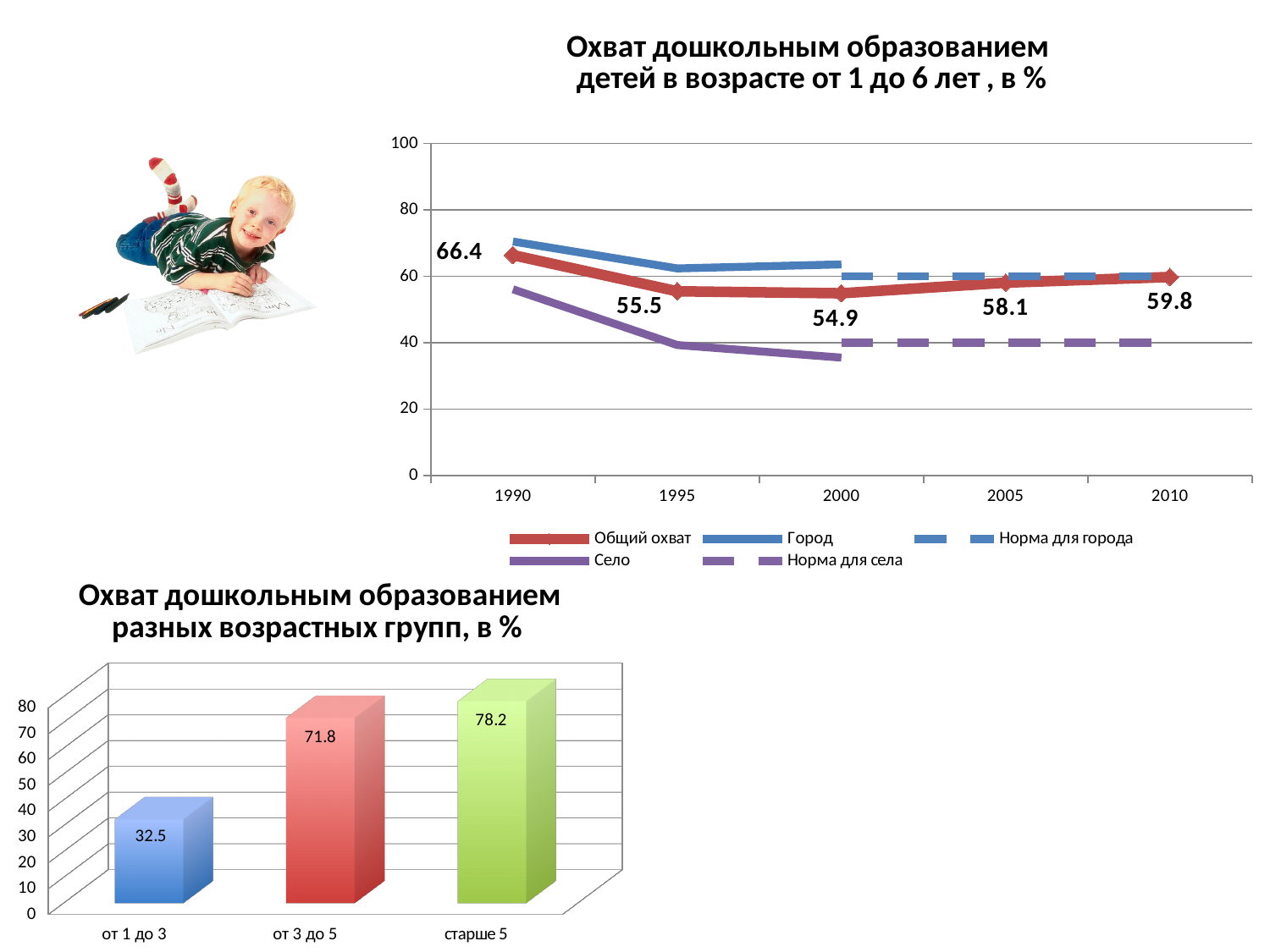
In the top chart 'Охват дошкольным образованием детей в возрасте от 1 до 6 лет', by how much did 'Общий охват' fall from 1990 to 1995? 10.9 In the top chart 'Охват дошкольным образованием детей в возрасте от 1 до 6 лет', is the value for 'Село' in 2000 greater or less than 40? less In the bottom chart 'Охват дошкольным образованием разных возрастных групп', which age group has the highest value? старше 5 In the bottom chart 'Охват дошкольным образованием разных возрастных групп', what is the difference between 'старше 5' and 'от 1 до 3'? 45.7 In the top chart 'Охват дошкольным образованием детей в возрасте от 1 до 6 лет', which series is higher in 1995, 'Город' or 'Село'? Город In the top chart 'Охват дошкольным образованием детей в возрасте от 1 до 6 лет', what is the value of 'Общий охват' in 1990? 66.4 In the bottom chart 'Охват дошкольным образованием разных возрастных групп', what is the value for 'от 3 до 5'? 71.8 In the top chart 'Охват дошкольным образованием детей в возрасте от 1 до 6 лет', what is the value of 'Общий охват' in 2010? 59.8 In the top chart 'Охват дошкольным образованием детей в возрасте от 1 до 6 лет', what is the value of 'Общий охват' in 2000? 54.9 What kind of chart is the bottom chart 'Охват дошкольным образованием разных возрастных групп'? bar chart In the top chart 'Охват дошкольным образованием детей в возрасте от 1 до 6 лет', how many series does the legend list? 5 In the top chart 'Охват дошкольным образованием детей в возрасте от 1 до 6 лет', in which year is 'Общий охват' lowest? 2000